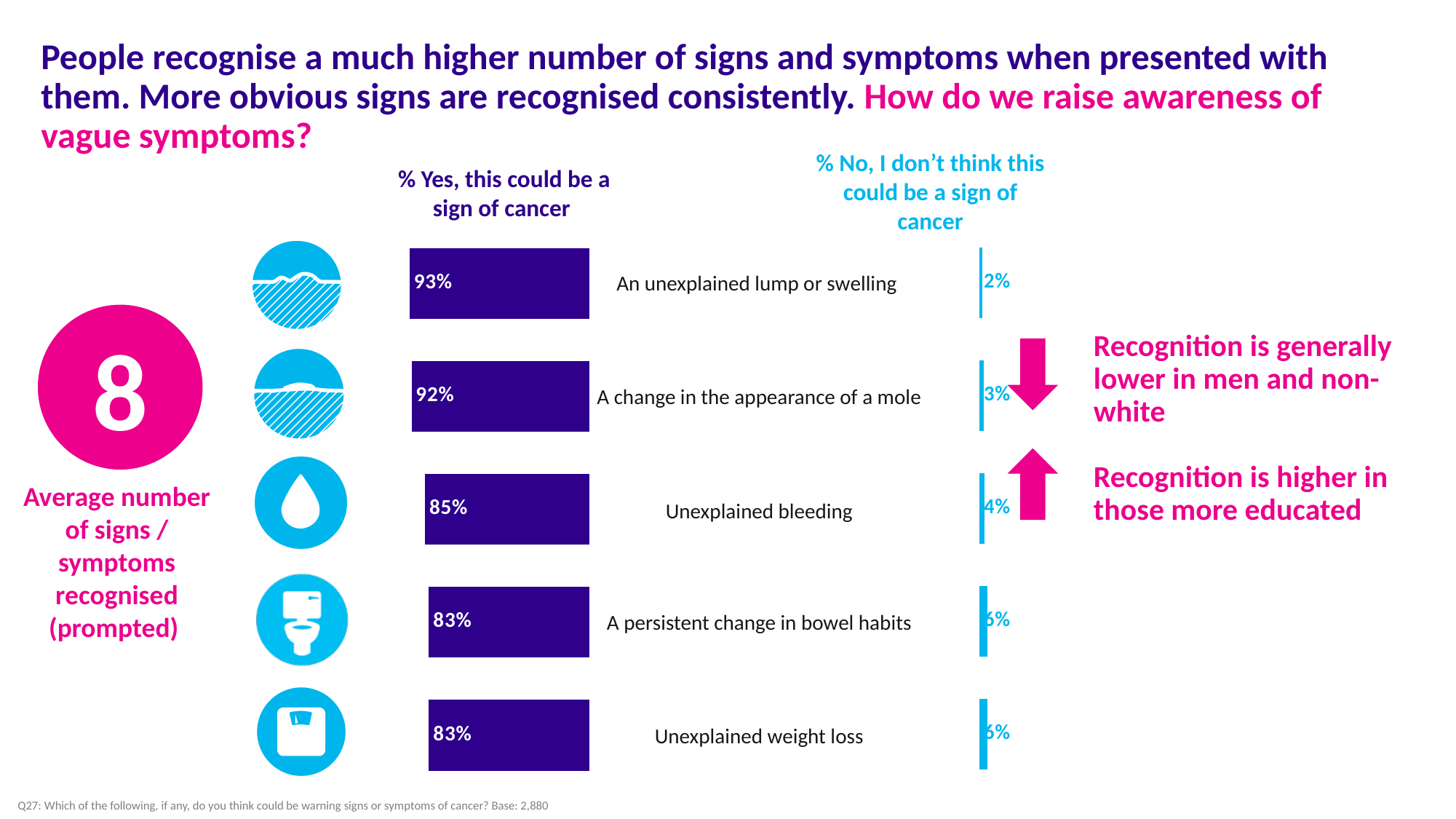
In the '% Yes, this could be a sign of cancer' chart, which category has the highest value? An unexplained lump or swelling In the '% Yes, this could be a sign of cancer' chart, do the values rise or fall going down the list from 'An unexplained lump or swelling' to 'Unexplained weight loss'? Fall In the '% Yes, this could be a sign of cancer' chart, which is larger: 'A change in the appearance of a mole' or 'A persistent change in bowel habits'? A change in the appearance of a mole In the '% Yes, this could be a sign of cancer' chart, what is the value for 'A change in the appearance of a mole'? 92% In the '% No, I don't think this could be a sign of cancer' chart, what is the value for 'Unexplained bleeding'? 4% How many categories are shown in the '% Yes, this could be a sign of cancer' chart? 5 In the '% Yes, this could be a sign of cancer' chart, what is the difference between 'An unexplained lump or swelling' and 'Unexplained bleeding'? 8% In the '% No, I don't think this could be a sign of cancer' chart, which category has the lowest value? An unexplained lump or swelling In the '% No, I don't think this could be a sign of cancer' chart, what is the value for 'An unexplained lump or swelling'? 2% In the '% Yes, this could be a sign of cancer' chart, what is the value for 'An unexplained lump or swelling'? 93% In the '% Yes, this could be a sign of cancer' chart, what is the value for 'Unexplained bleeding'? 85% What kind of chart is the '% Yes, this could be a sign of cancer' chart? Bar chart